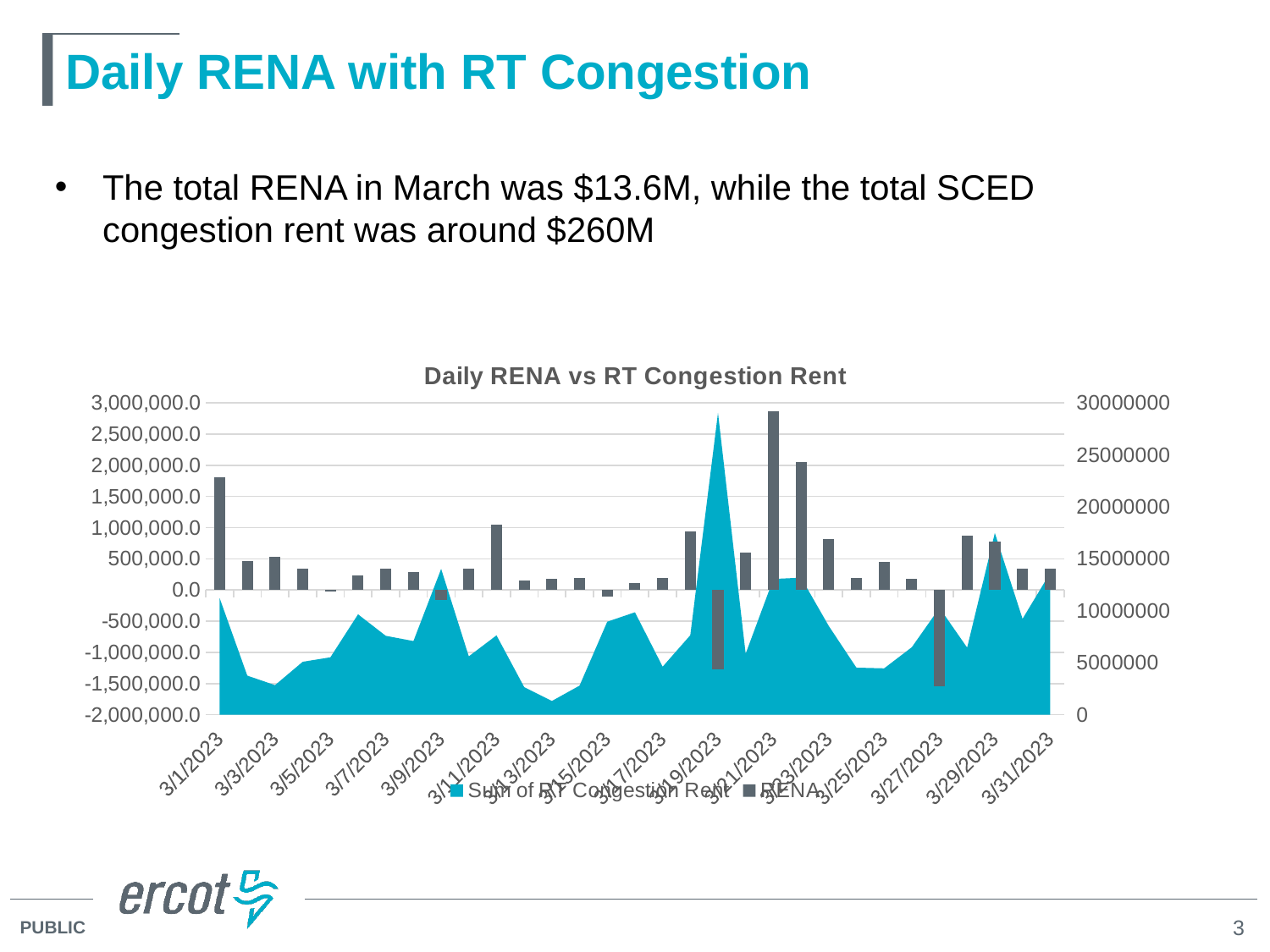
Which date has the larger RENA bar, 3/21/2023 or 3/23/2023? 3/21/2023 Is the RENA value for 3/21/2023 greater or less than 2,500,000.0 on the left axis? greater On which date is the RENA bar the highest? 3/21/2023 What kind of chart is shown on the slide? A combination chart with an area series and a bar series Is the RENA value for 3/27/2023 greater or less than -1,000,000.0 on the left axis? less On which date does the Sum of RT Congestion Rent area reach its highest peak? 3/19/2023 What are the two series named in the chart's legend? Sum of RT Congestion Rent and RENA On which date is the RENA bar the lowest (most negative)? 3/27/2023 What is the title of the chart on the slide? Daily RENA vs RT Congestion Rent Is the RENA value for 3/1/2023 greater or less than 1,500,000.0 on the left axis? greater Which date has the larger RENA bar, 3/1/2023 or 3/2/2023? 3/1/2023 How many series does the chart's legend list? 2